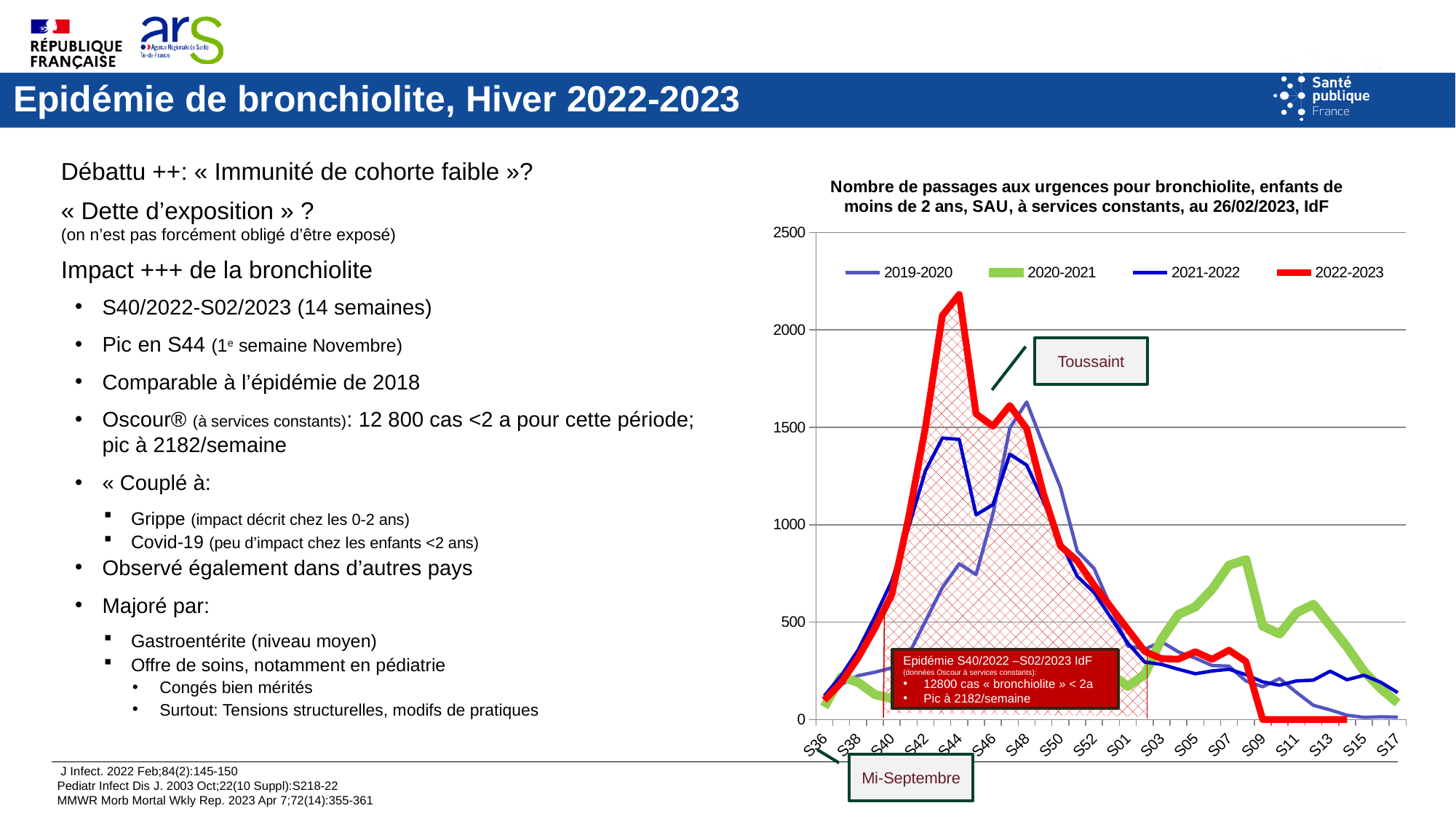
Is the peak value of the 2019-2020 series greater or less than 1500? greater Is the peak value of the 2020-2021 series greater or less than 1000? less What is the peak weekly value of the 2022-2023 series, as stated on the chart annotation? 2182/semaine Does the 2022-2023 series rise or fall between S44 and S52? fall Is the peak value of the 2022-2023 series greater or less than 2000? greater How many series does the chart legend list? 4 At week S07, which series is higher: 2020-2021 or 2022-2023? 2020-2021 How many week labels are shown on the x axis? 18 What colour is the 2022-2023 series drawn in? red Which season's series reaches the highest peak on the chart? 2022-2023 Which season's series has the lowest peak on the chart? 2020-2021 What kind of chart is shown on the slide? line chart